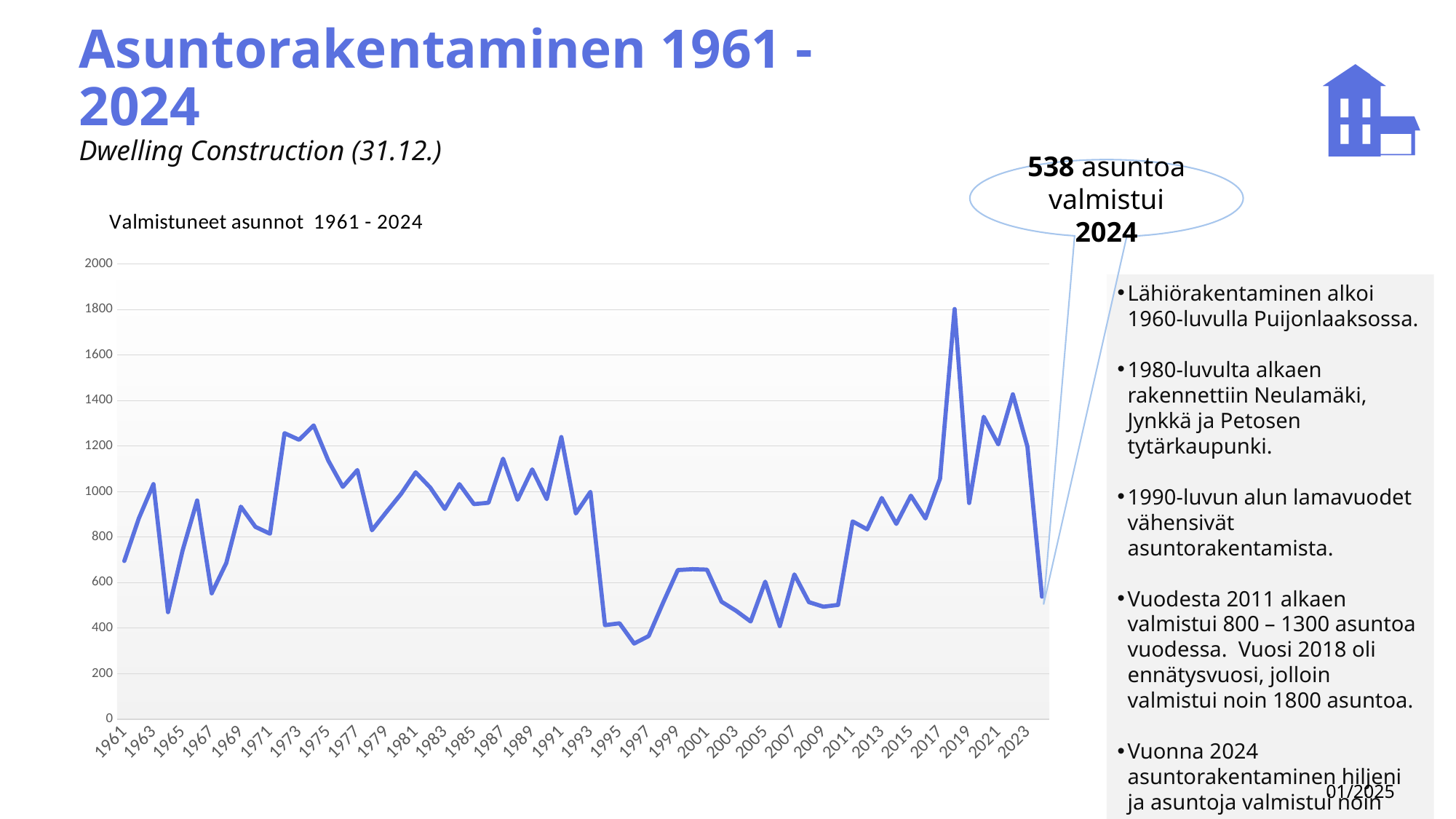
Which year has the larger value, 2018 or 2021? 2018 In which year does the line reach its highest value? 2018 Is the value for 1961 greater or less than 800? less Is the value for 1991 greater or less than 1000? greater What is the title of the chart? Valmistuneet asunnot 1961 - 2024 What kind of chart is shown on the slide? line chart Is the value for 2024 greater or less than 600? less Which year has the larger value, 1965 or 1971? 1971 What is the highest value shown on the vertical axis? 2000 How many dwellings were completed in 2024 according to the slide? 538 Does the line rise or fall between 1993 and 1996? fall